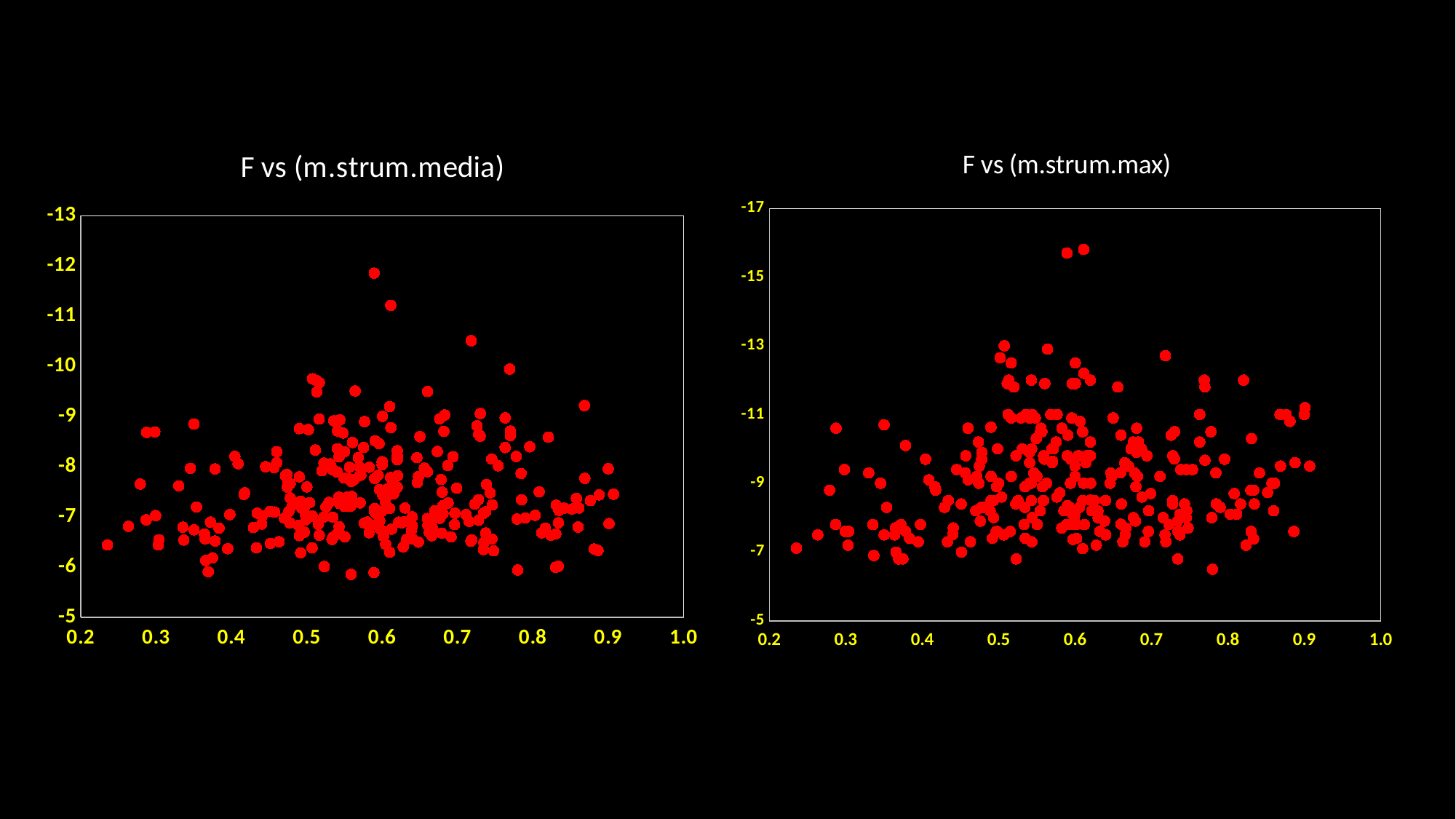
What is the topmost y-axis tick label on the chart titled "F vs (m.strum.max)"? -17 What kind of chart is the chart titled "F vs (m.strum.max)"? scatter plot In the chart titled "F vs (m.strum.media)", is the x value of the leftmost point greater or less than 0.3? less In the chart titled "F vs (m.strum.media)", is the y value of the topmost point greater or less than -11? less In the chart titled "F vs (m.strum.max)", is the x value of the leftmost point greater or less than 0.3? less What is the title of the chart on the right of the slide? F vs (m.strum.max) What kind of chart is the chart titled "F vs (m.strum.media)"? scatter plot